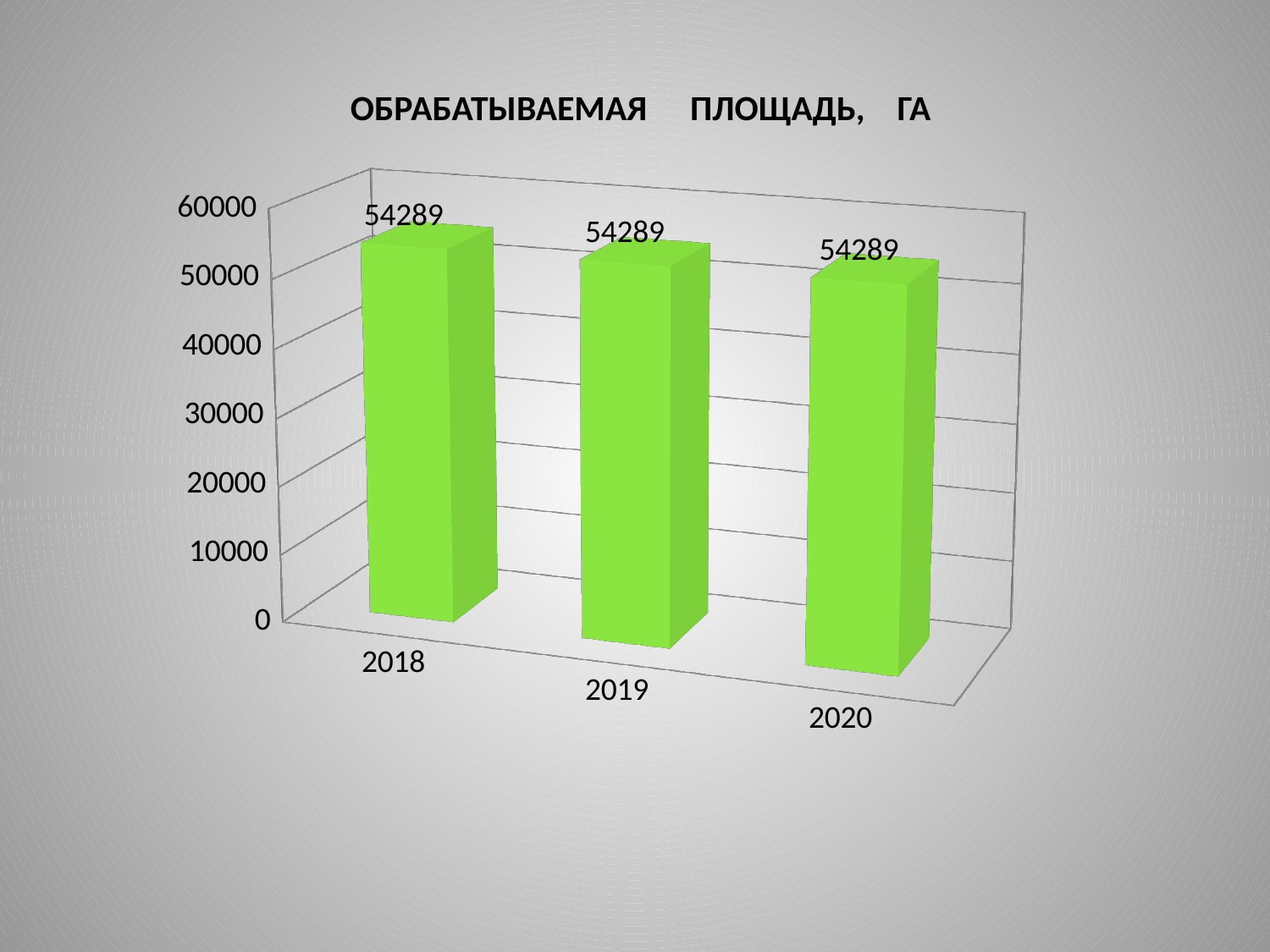
How many categories (years) are shown on the x axis? 3 Is the value for 2019 greater or less than 50000? greater Is the value for 2020 greater or less than 60000? less What is the value for 2020? 54289 What is the difference between the values for 2018 and 2020? 0 What colour are the bars in the chart? green What is the title of the chart? ОБРАБАТЫВАЕМАЯ ПЛОЩАДЬ, ГА What is the value for 2019? 54289 What is the difference between the values for 2019 and 2020? 0 What is the value for 2018? 54289 Do the values rise, fall, or stay the same from 2018 to 2020? stay the same What kind of chart is shown on the slide? bar chart